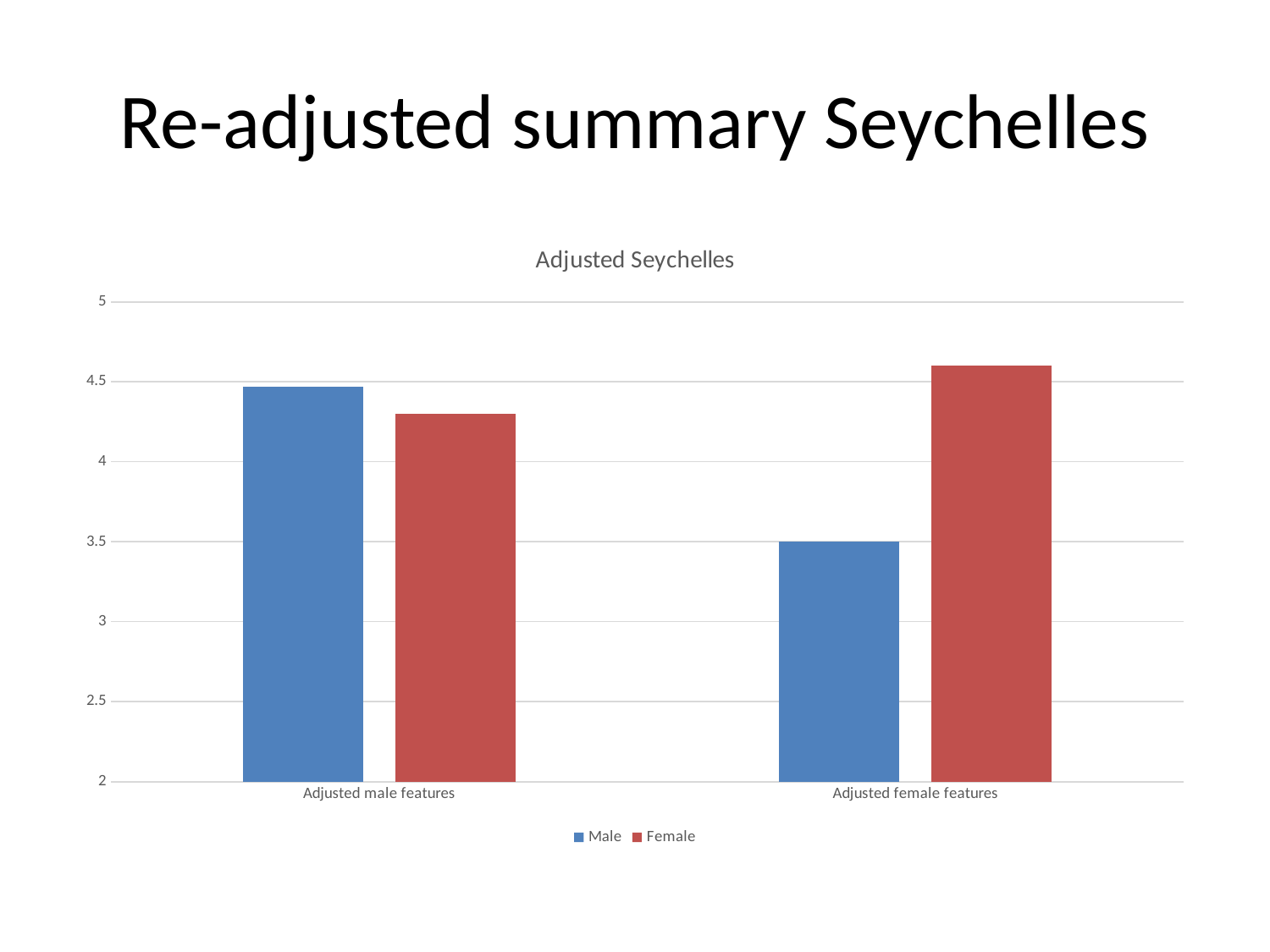
Which bar is the lowest in the chart? Male for Adjusted female features What type of chart is shown on the slide? Bar chart What is the title of the chart? Adjusted Seychelles Is the Male value for Adjusted female features greater or less than 4? less How many categories are shown on the x axis? 2 Which colour represents the Male series? Blue Is the Female value for Adjusted male features greater or less than 4? greater For Adjusted male features, which series has the larger value, Male or Female? Male Is the Male value for Adjusted male features greater or less than 4? greater How many series does the legend list? 2 For Adjusted female features, which series has the larger value, Male or Female? Female